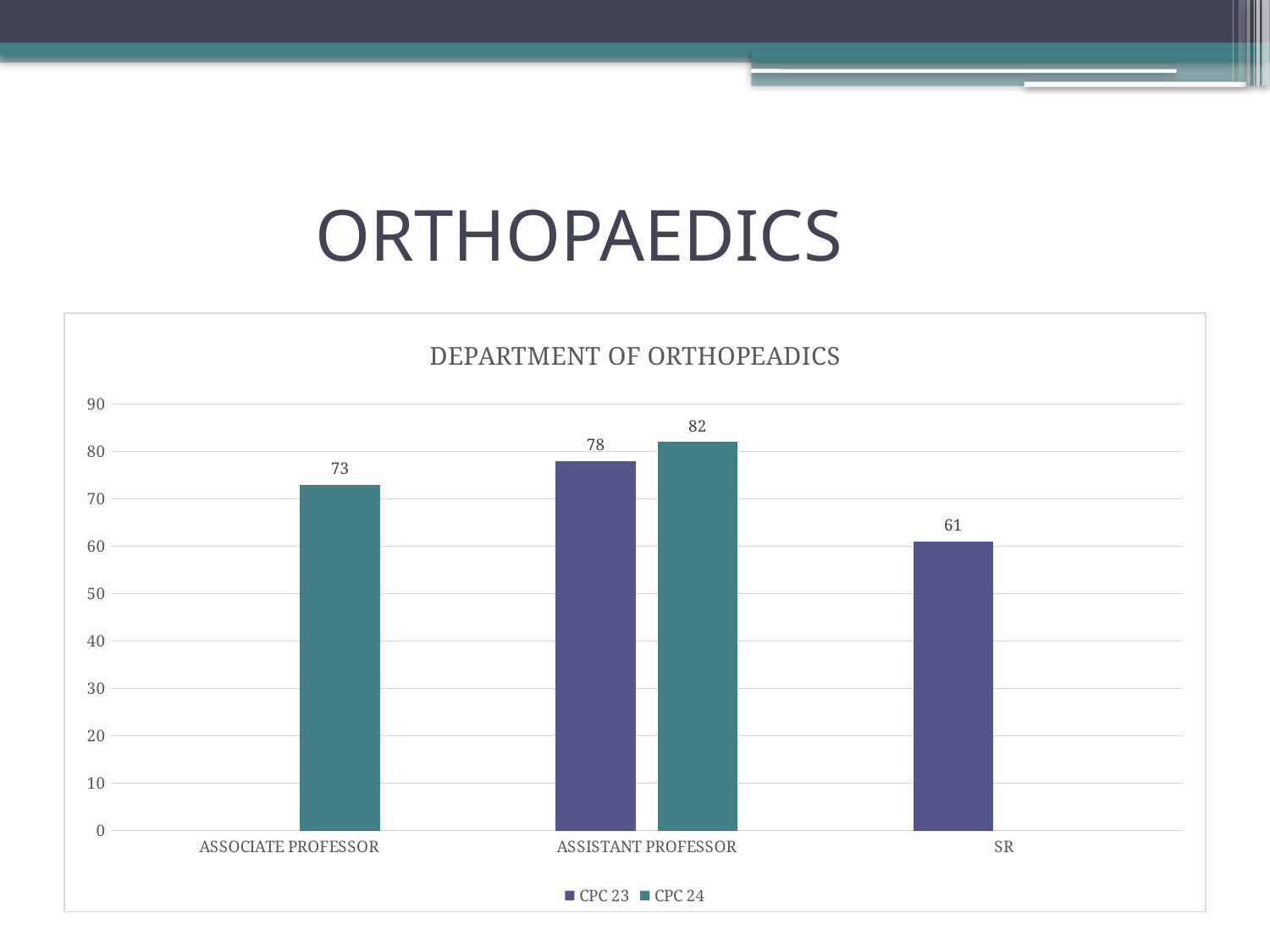
Is the CPC 23 value for SR greater or less than 70? less What kind of chart is shown on the slide? bar chart What is the difference between the CPC 24 and CPC 23 values for ASSISTANT PROFESSOR? 4 Which is larger for ASSISTANT PROFESSOR, CPC 23 or CPC 24? CPC 24 How many categories are shown on the x axis? 3 Which category has the highest CPC 24 value? ASSISTANT PROFESSOR How many series does the legend list? 2 Which category has the lowest CPC 23 value? SR What is the CPC 23 value for SR? 61 What is the CPC 24 value for ASSISTANT PROFESSOR? 82 What is the CPC 23 value for ASSISTANT PROFESSOR? 78 What is the CPC 24 value for ASSOCIATE PROFESSOR? 73